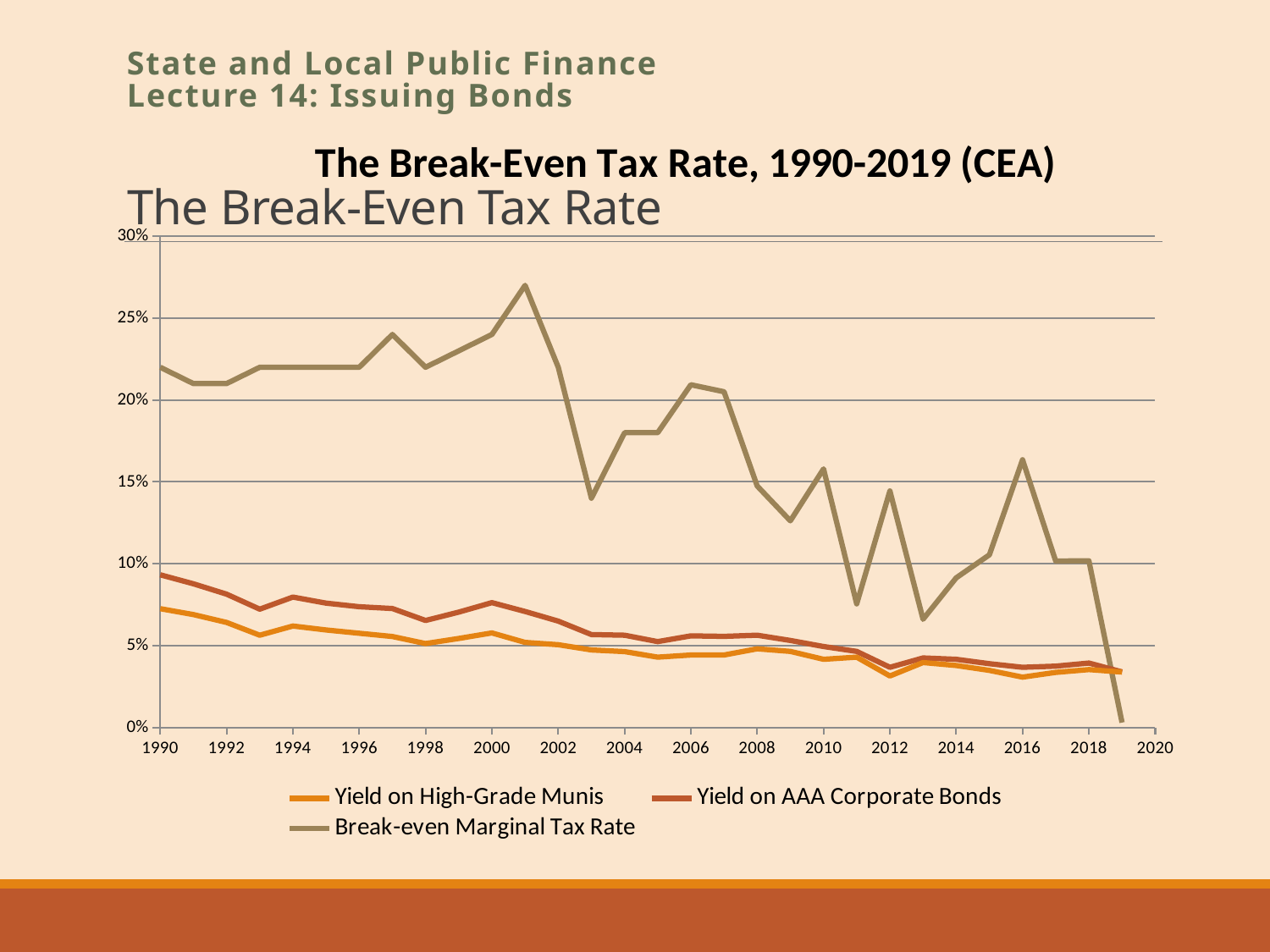
What kind of chart is shown on the slide? Line chart Is the Break-even Marginal Tax Rate in 2011 greater or less than 10%? less Is the Break-even Marginal Tax Rate in 2001 greater or less than 25%? greater In which year does the Break-even Marginal Tax Rate reach its highest point? 2001 Does the Yield on High-Grade Munis generally rise or fall from 1990 to 2019? fall Is the Yield on AAA Corporate Bonds in 1990 greater or less than 10%? less How many series does the legend list? 3 What is the title printed above the chart? The Break-Even Tax Rate, 1990-2019 (CEA) In 1990, which is higher: the Yield on AAA Corporate Bonds or the Yield on High-Grade Munis? Yield on AAA Corporate Bonds What are the three series listed in the legend? Yield on High-Grade Munis, Yield on AAA Corporate Bonds, Break-even Marginal Tax Rate